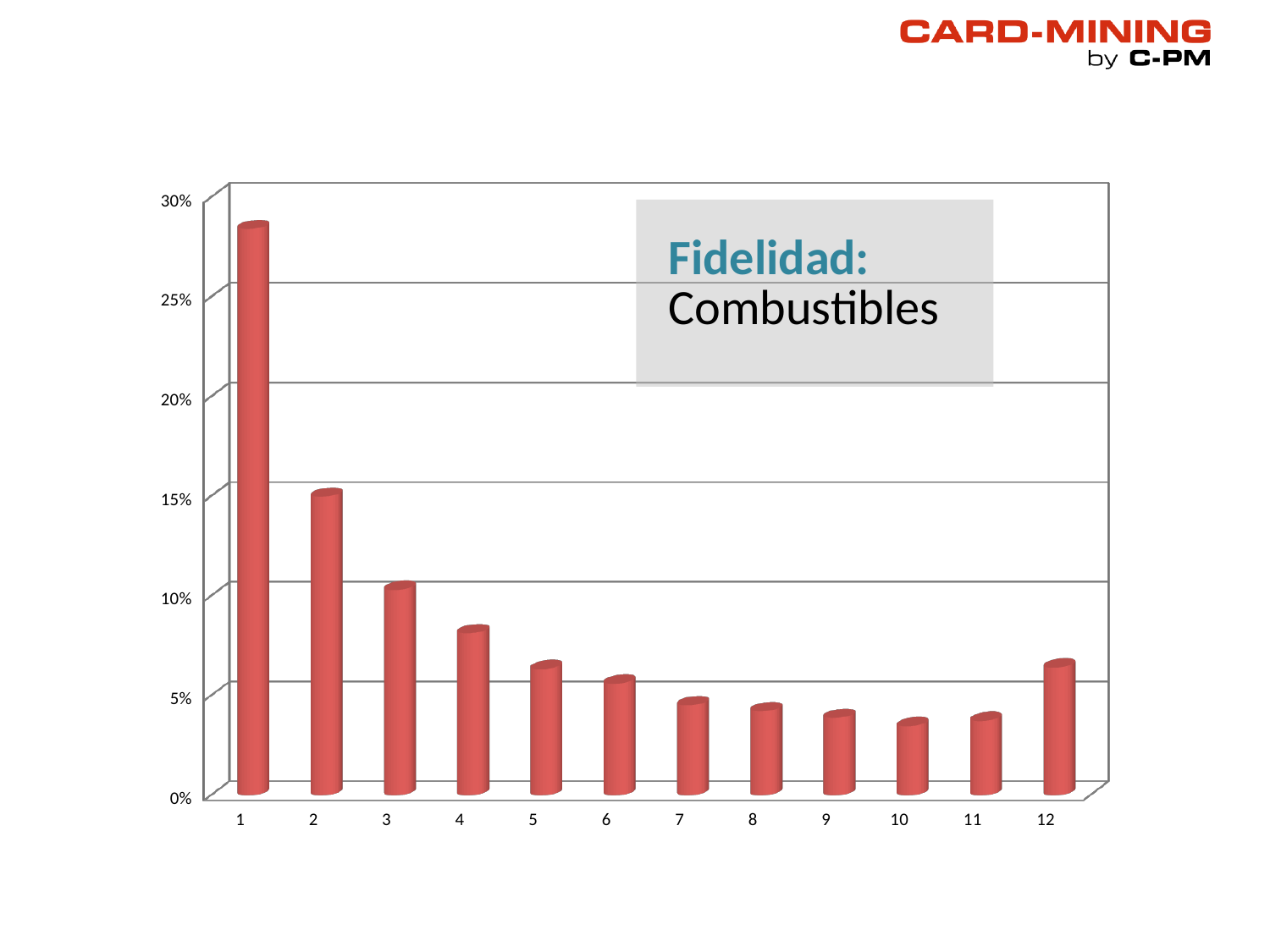
Is the value for category 2 greater or less than 20%? less Is the value for category 4 greater or less than 10%? less Which has the larger value, category 2 or category 3? 2 What kind of chart is shown on the slide? bar chart How many bars (categories) are plotted on the chart? 12 What text appears in the box overlaid on the chart? Fidelidad: Combustibles Is the value for category 12 greater or less than 5%? greater Which has the larger value, category 11 or category 12? 12 Which category has the highest value? 1 Do the values generally rise or fall from category 1 to category 11? fall